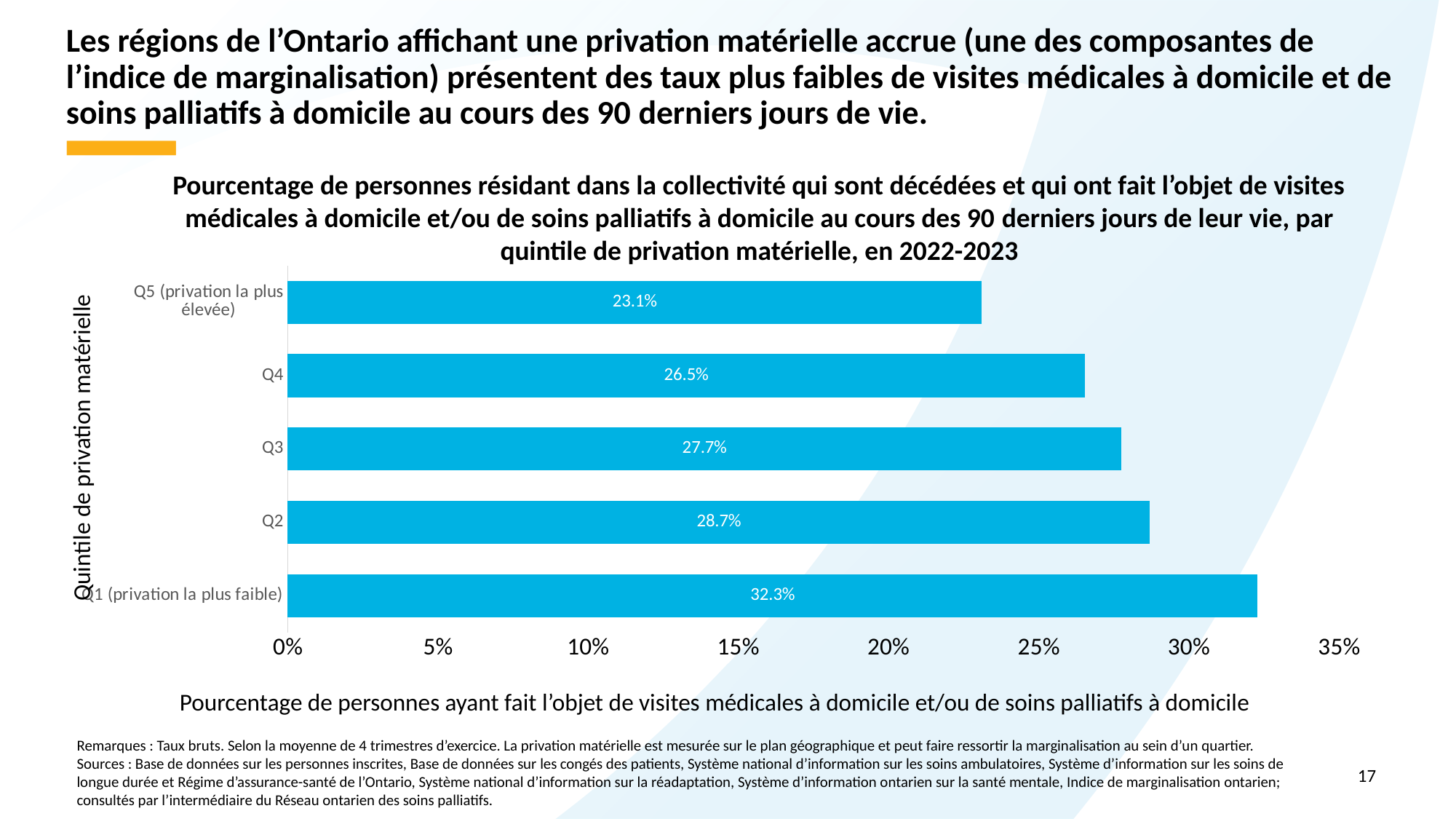
Which quintile has the highest value? Q1 (privation la plus faible) How many quintile categories are shown in the chart? 5 What is the value for Q5 (privation la plus élevée)? 23.1% Is the value for Q3 greater or less than 25%? greater What is the label of the horizontal axis of the chart? Pourcentage de personnes ayant fait l’objet de visites médicales à domicile et/ou de soins palliatifs à domicile Which is larger, the value for Q2 or the value for Q4? Q2 What is the value for Q1 (privation la plus faible)? 32.3% What is the difference between the values for Q2 and Q3? 1.0% Which quintile has the lowest value? Q5 (privation la plus élevée) What is the difference between the values for Q1 (privation la plus faible) and Q5 (privation la plus élevée)? 9.2% What kind of chart is shown on the slide? Bar chart What is the value for Q4? 26.5%